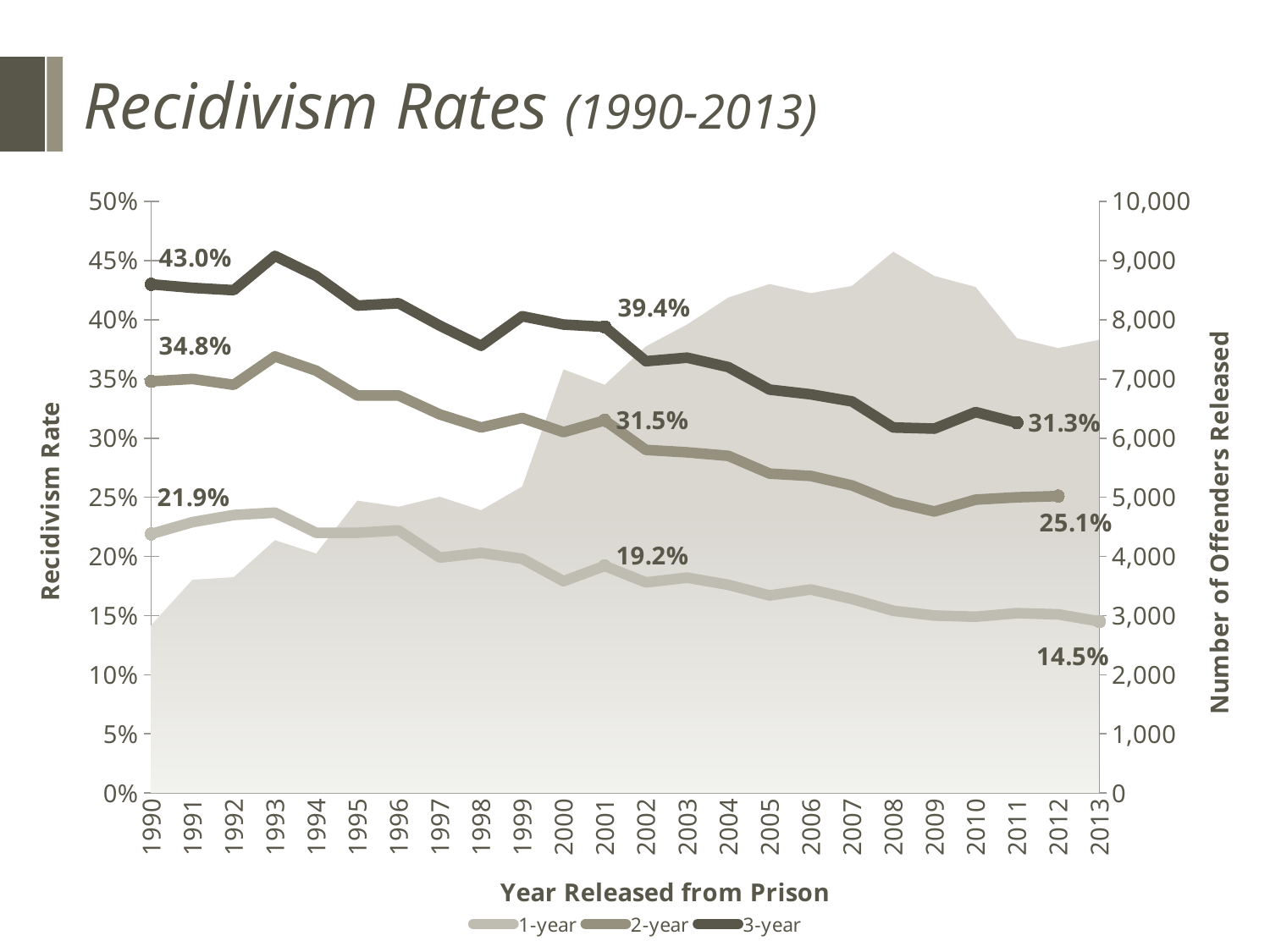
What is the 2-year recidivism rate for offenders released in 2001? 31.5% Does the 3-year recidivism rate generally rise or fall from 1990 to 2011? fall What is the 3-year recidivism rate for offenders released in 1990? 43.0% What is the 2-year recidivism rate for offenders released in 2012? 25.1% Is the 1-year recidivism rate for 2000 greater or less than 20%? less By how many percentage points did the 3-year recidivism rate fall from 1990 (43.0%) to 2011 (31.3%)? 11.7 percentage points What is the 1-year recidivism rate for offenders released in 2013? 14.5% How many series does the legend list? 3 Which series has the highest recidivism rate in 1990: 1-year, 2-year or 3-year? 3-year By how many percentage points did the 1-year recidivism rate fall from 1990 (21.9%) to 2013 (14.5%)? 7.4 percentage points What is the title of the slide's chart? Recidivism Rates (1990-2013) Which is larger in 2001, the 2-year rate or the 1-year rate? 2-year